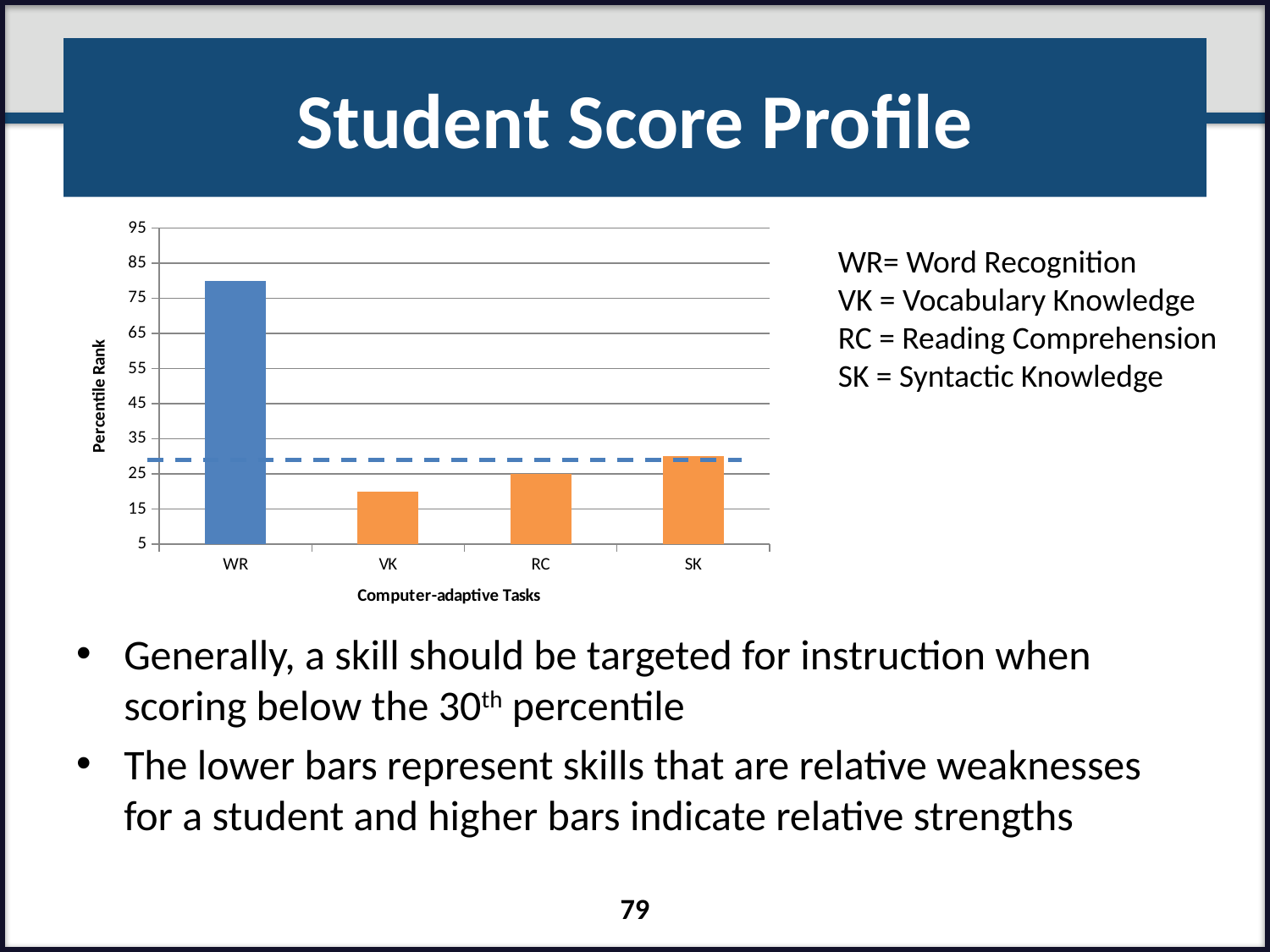
Is the percentile rank for SK greater or less than 25? greater Which task has the highest percentile rank? WR Is the percentile rank for VK greater or less than 25? less What is the percentile rank for RC? 25 Which task has the lowest percentile rank? VK What is the title of the chart's horizontal axis? Computer-adaptive Tasks How many computer-adaptive tasks are plotted on the chart? 4 Which has a higher percentile rank, RC or VK? RC Which has a higher percentile rank, WR or SK? WR What kind of chart is shown on the slide? bar chart What is the title of the chart's vertical axis? Percentile Rank Is the percentile rank for WR greater or less than 75? greater